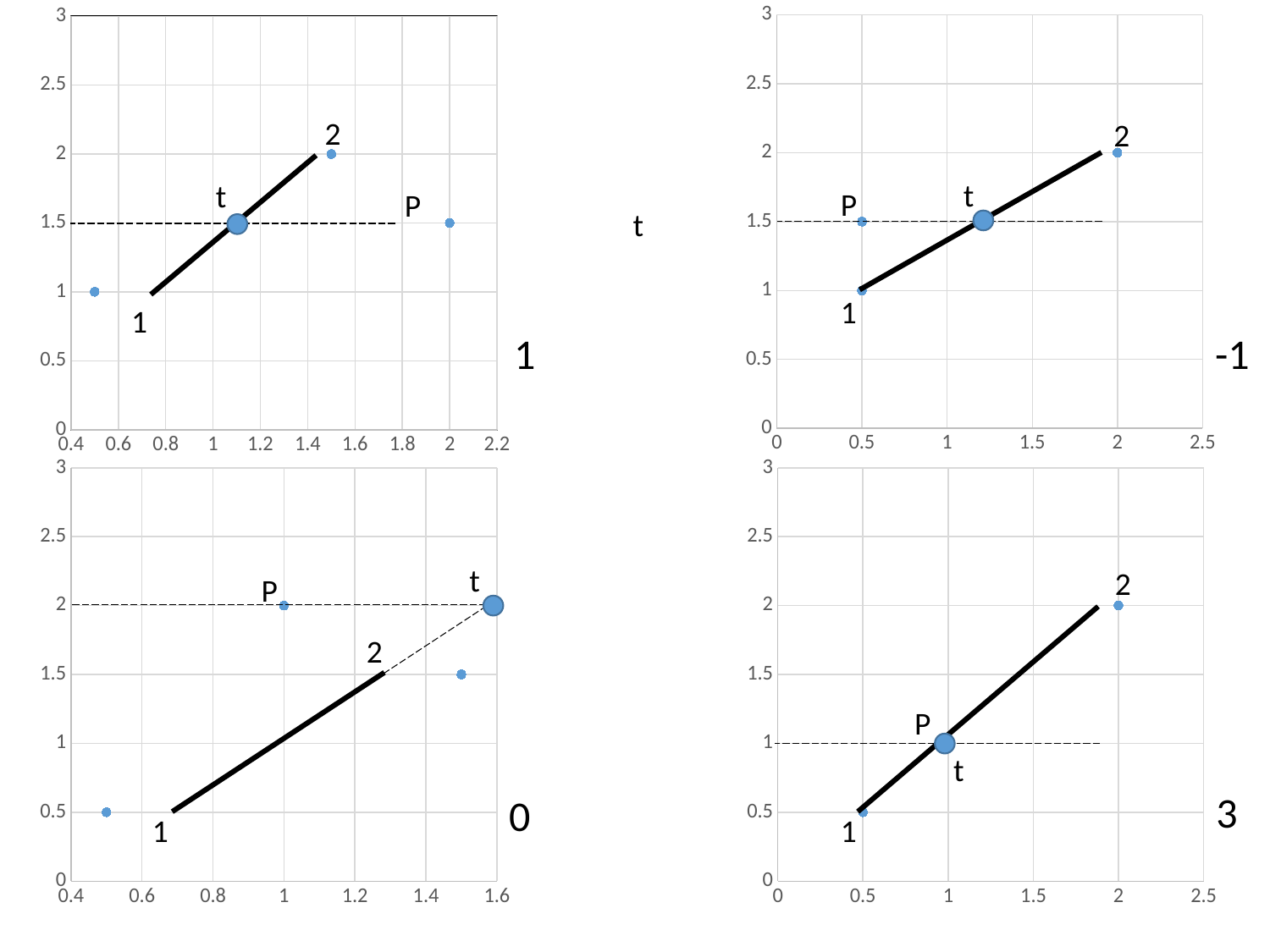
In the top-left chart, what is the y value of the dashed horizontal line through point P? 1.5 In the top-right chart, what is the x value of point 2? 2 In the top-left chart, is the y value of point 2 greater or less than 1.5? greater In the top-right chart, what is the y value of point 1? 1 What is the maximum value shown on the y axis of the bottom-right chart? 3 In the bottom-left chart, is the y value of point 1 greater or less than 1? less What kind of chart is the top-left chart? scatter chart How many charts are shown on the slide? 4 In the top-right chart, which point has the higher y value, point 1 or point 2? point 2 In the bottom-right chart, what is the x value of point 1? 0.5 In the bottom-right chart, what is the y value of point P? 1 In the bottom-left chart, what is the y value of the dashed horizontal line through point P? 2